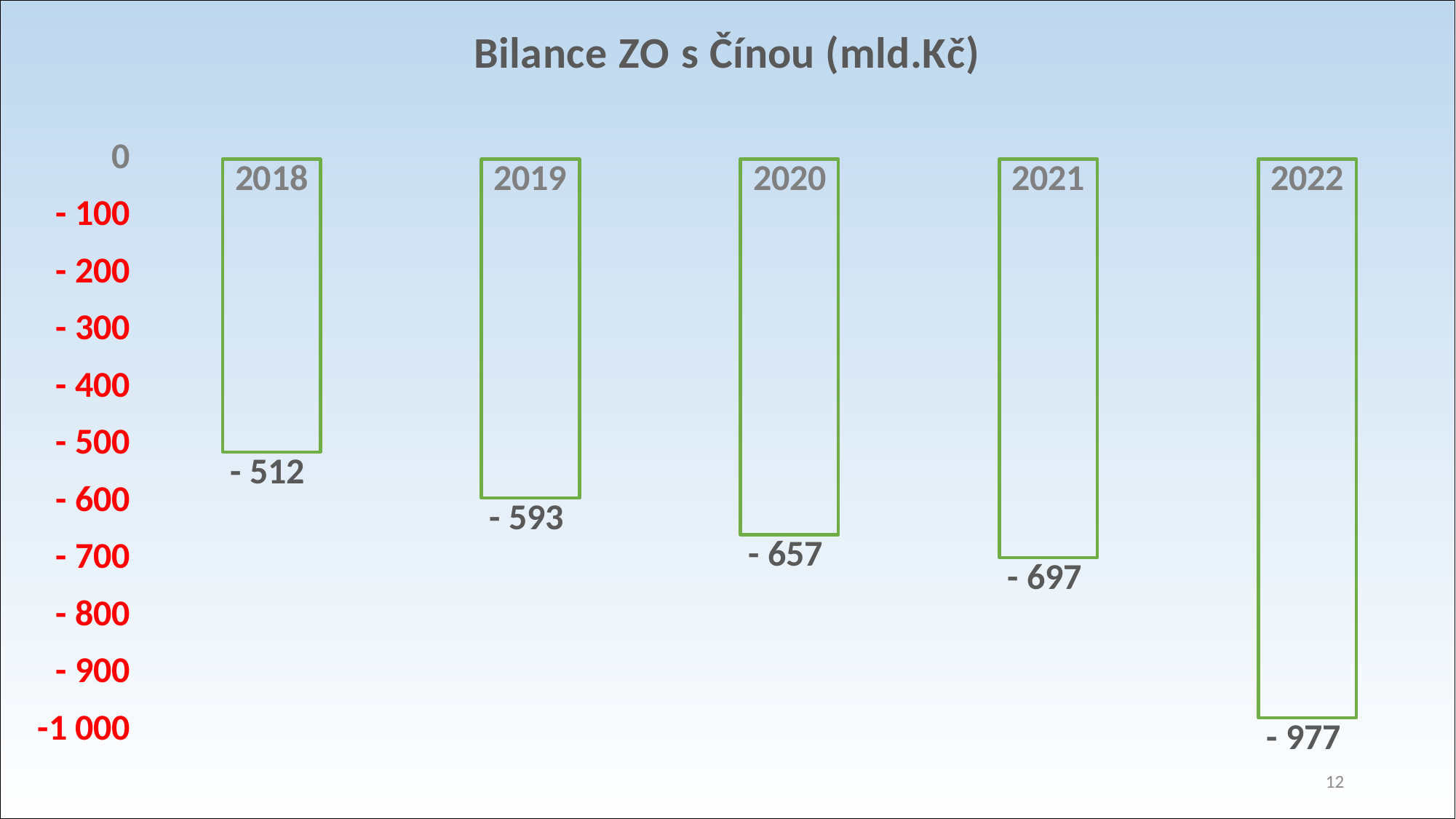
What is the difference between the values for 2021 and 2020? 40 Which year has the highest (least negative) value? 2018 Do the values rise or fall from 2018 to 2022? fall What is the value for 2020 in the chart? - 657 What is the value for 2022 in the chart? - 977 What is the value for 2018 in the chart? - 512 Which year has the lowest (most negative) value? 2022 By how much does the value for 2022 differ from the value for 2018? 465 Which year has the larger deficit, 2019 or 2021? 2021 What type of chart is shown on the slide? bar chart How many years are shown in the chart? 5 What is the title of the chart? Bilance ZO s Čínou (mld.Kč)